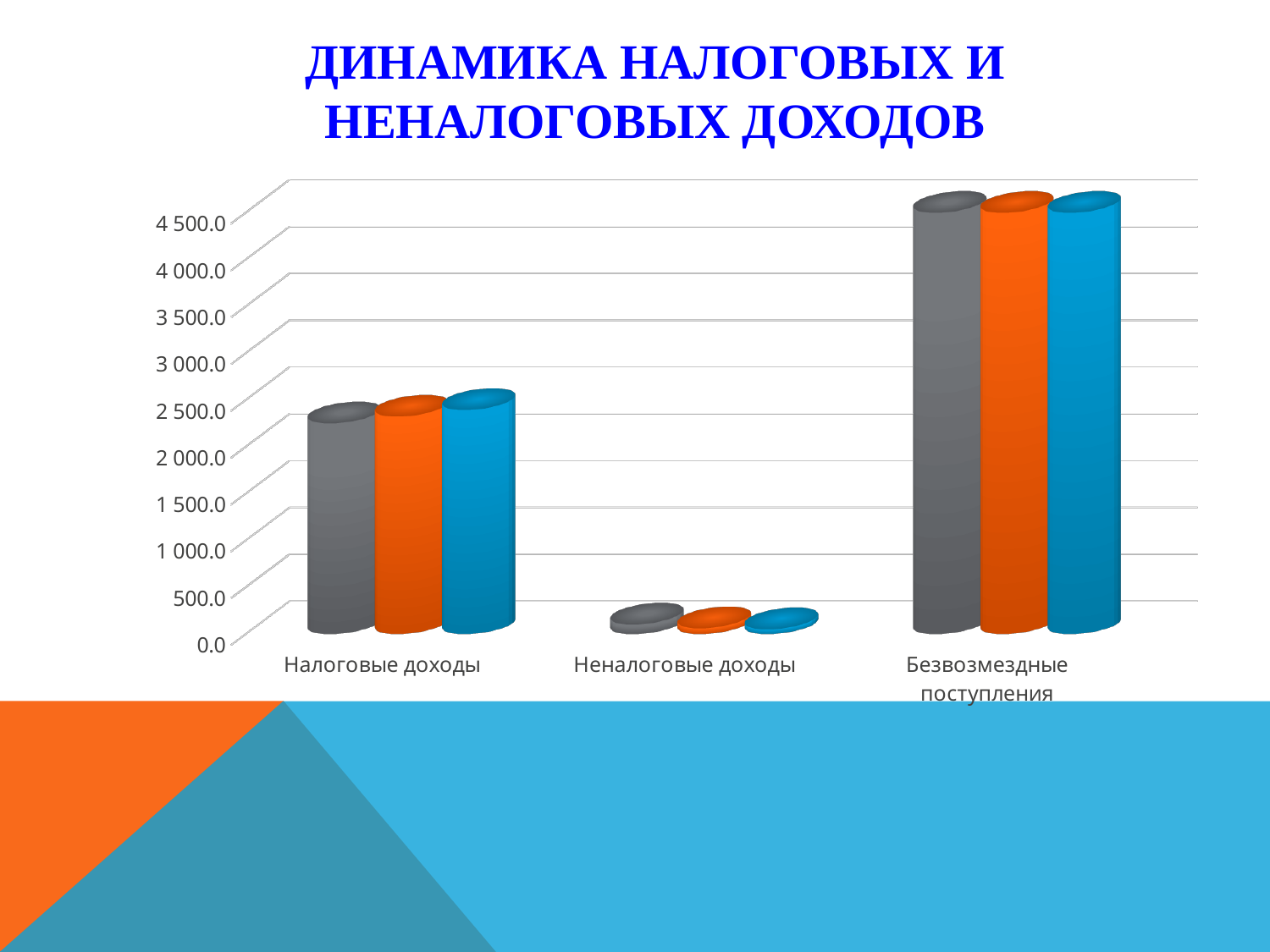
Which is larger, the gray bar for Налоговые доходы or the gray bar for Безвозмездные поступления? Безвозмездные поступления Is the value of the first (gray) bar for Налоговые доходы greater or less than 3 000.0? less What is the title of the slide containing the chart? ДИНАМИКА НАЛОГОВЫХ И НЕНАЛОГОВЫХ ДОХОДОВ How many bars are plotted for each category in the chart? 3 What kind of chart is shown on the slide? Bar chart Which category has the lowest values in the chart? Неналоговые доходы Is the value of the first (gray) bar for Неналоговые доходы greater or less than 500.0? less Which category has the highest values in the chart? Безвозмездные поступления How many categories are shown on the x axis of the chart? 3 Is the value of the first (gray) bar for Налоговые доходы greater or less than 2 000.0? greater Which is larger, the blue bar for Неналоговые доходы or the blue bar for Налоговые доходы? Налоговые доходы